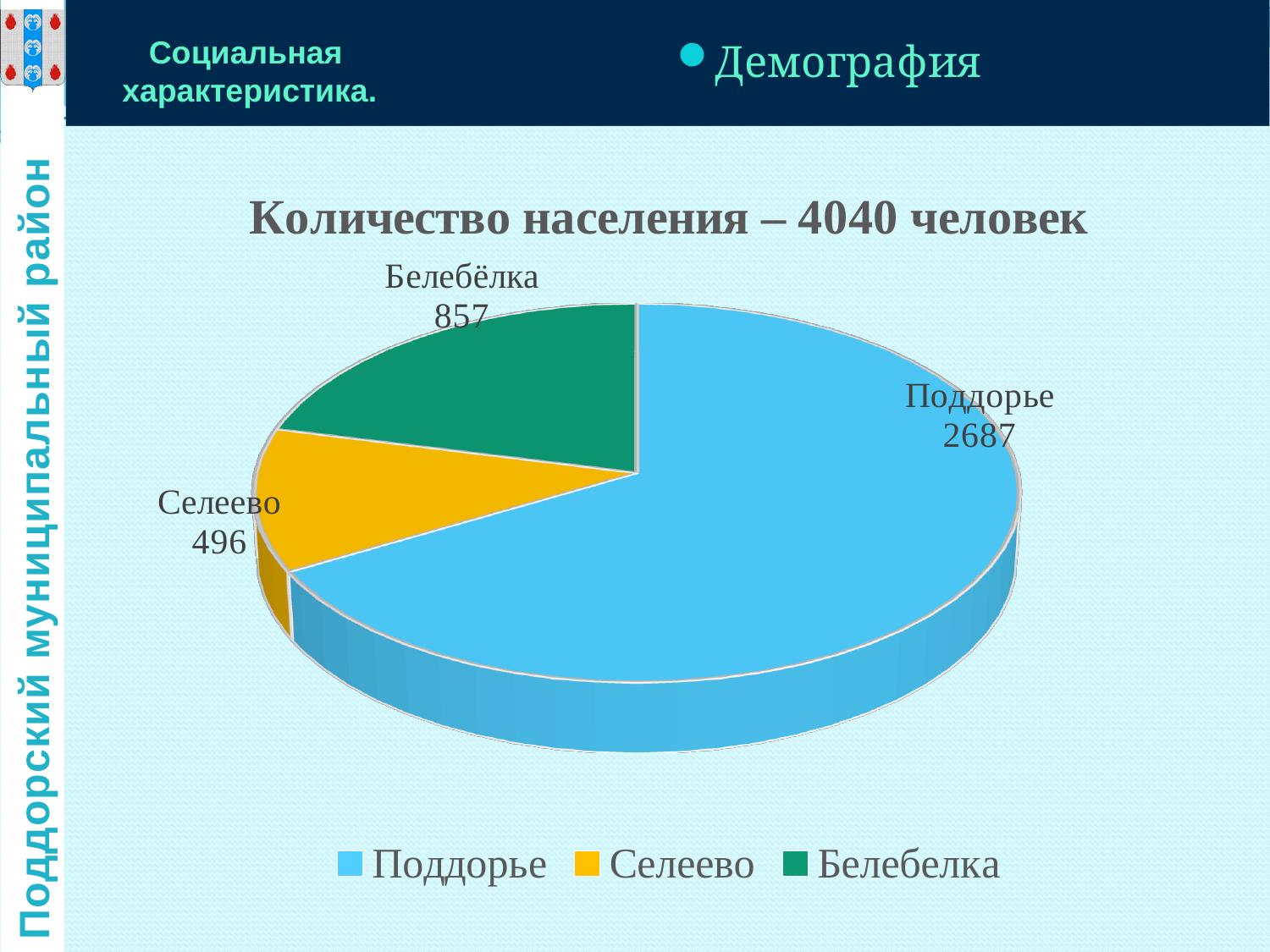
What type of chart is shown on the slide? pie chart What is the total population given in the chart title? 4040 человек What is the difference between the population of Поддорье and Белебёлка? 1830 Which settlement has the smallest slice of the pie chart? Селеево How much larger is the population of Белебёлка than that of Селеево? 361 Which settlement has the largest slice of the pie chart? Поддорье What is the population value shown for Поддорье in the pie chart? 2687 Which has a larger population, Селеево or Белебёлка? Белебёлка What is the population value shown for Белебёлка? 857 What is the population value shown for Селеево? 496 How many slices does the pie chart have? 3 What colour is the slice for Белебёлка in the pie chart? green